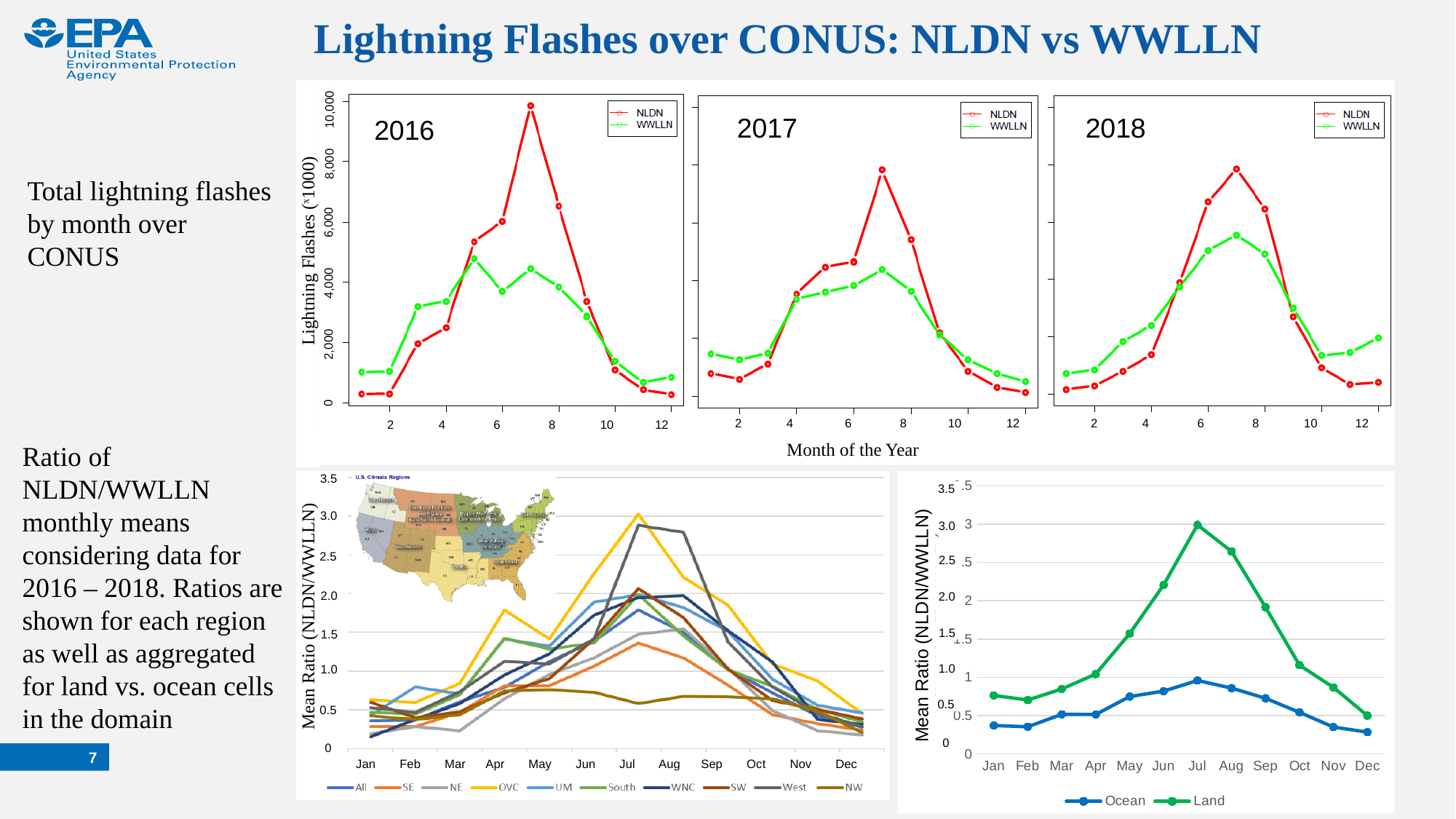
What kind of chart is the bottom-right chart comparing Ocean and Land? line chart How many series does the legend of the bottom-left regional ratio chart list? 10 In the 2016 chart, is the peak NLDN value greater or less than 8,000? greater In the bottom-right chart, which month has the highest Land ratio? Jul How many series does the legend of the 2016 chart list? 2 In the 2016 chart, at which month does the NLDN series reach its highest value? 7 In the 2017 chart, at month 7, which series is higher, NLDN or WWLLN? NLDN In the 2018 chart, is the WWLLN value at month 7 greater or less than 4,000? greater In the bottom-right chart, which month has the lowest Ocean ratio? Dec What is the x-axis title shared by the three top charts? Month of the Year In the 2016 chart, at month 3, which series is higher, NLDN or WWLLN? WWLLN In the 2018 chart, does the NLDN series rise or fall from month 7 to month 12? fall